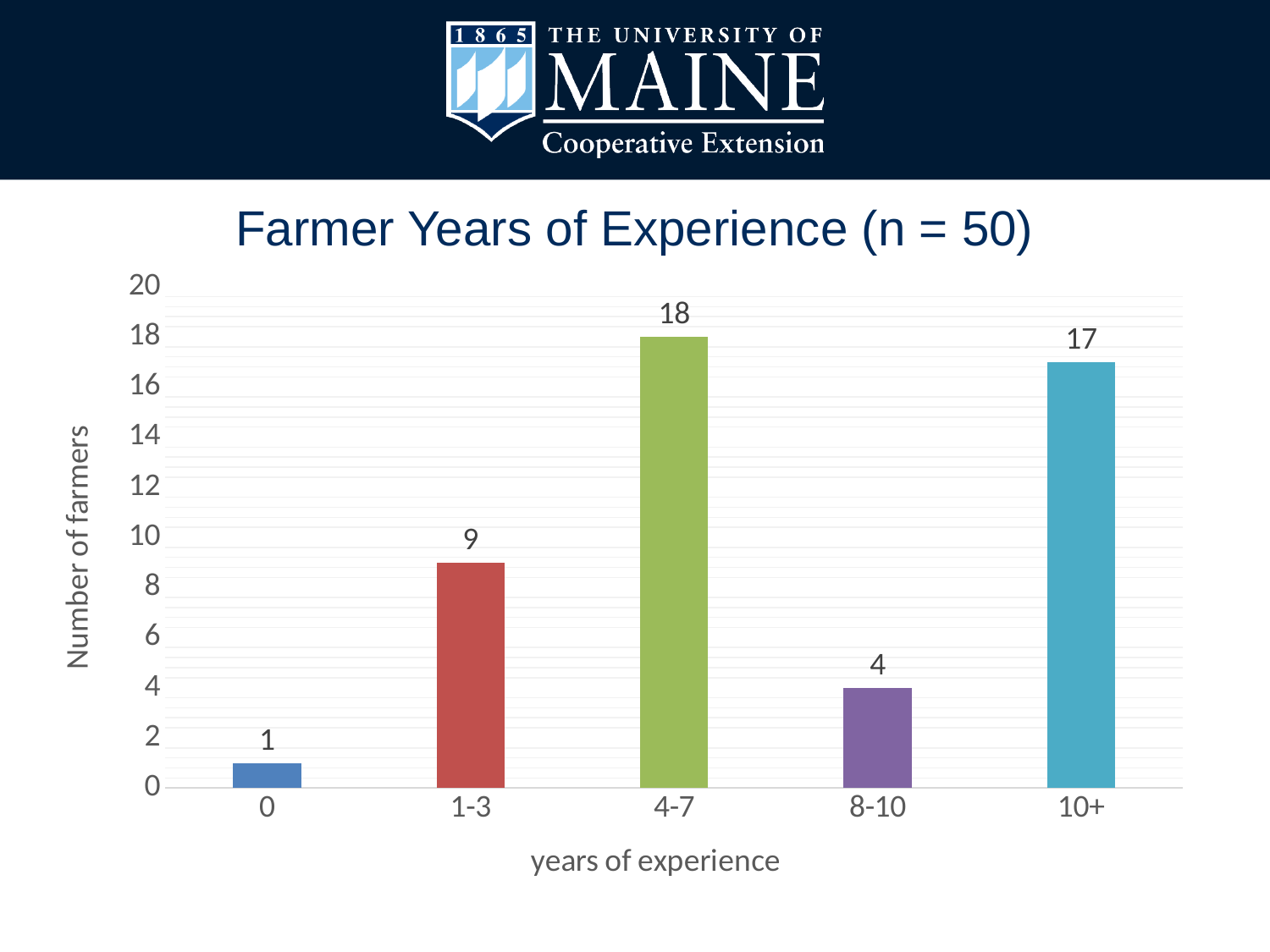
What is the difference in the number of farmers between the 10+ and 0 categories? 16 Which years-of-experience category has the lowest number of farmers? 0 What is the label of the y axis? Number of farmers How many farmers have 10+ years of experience? 17 What is the difference in the number of farmers between the 4-7 and 8-10 categories? 14 How many farmers have 1-3 years of experience? 9 Which category has more farmers, 1-3 years or 8-10 years? 1-3 What kind of chart is shown on the slide? Bar chart Which years-of-experience category has the highest number of farmers? 4-7 How many farmers have 4-7 years of experience? 18 How many years-of-experience categories are shown on the x axis? 5 What is the title of the chart? Farmer Years of Experience (n = 50)